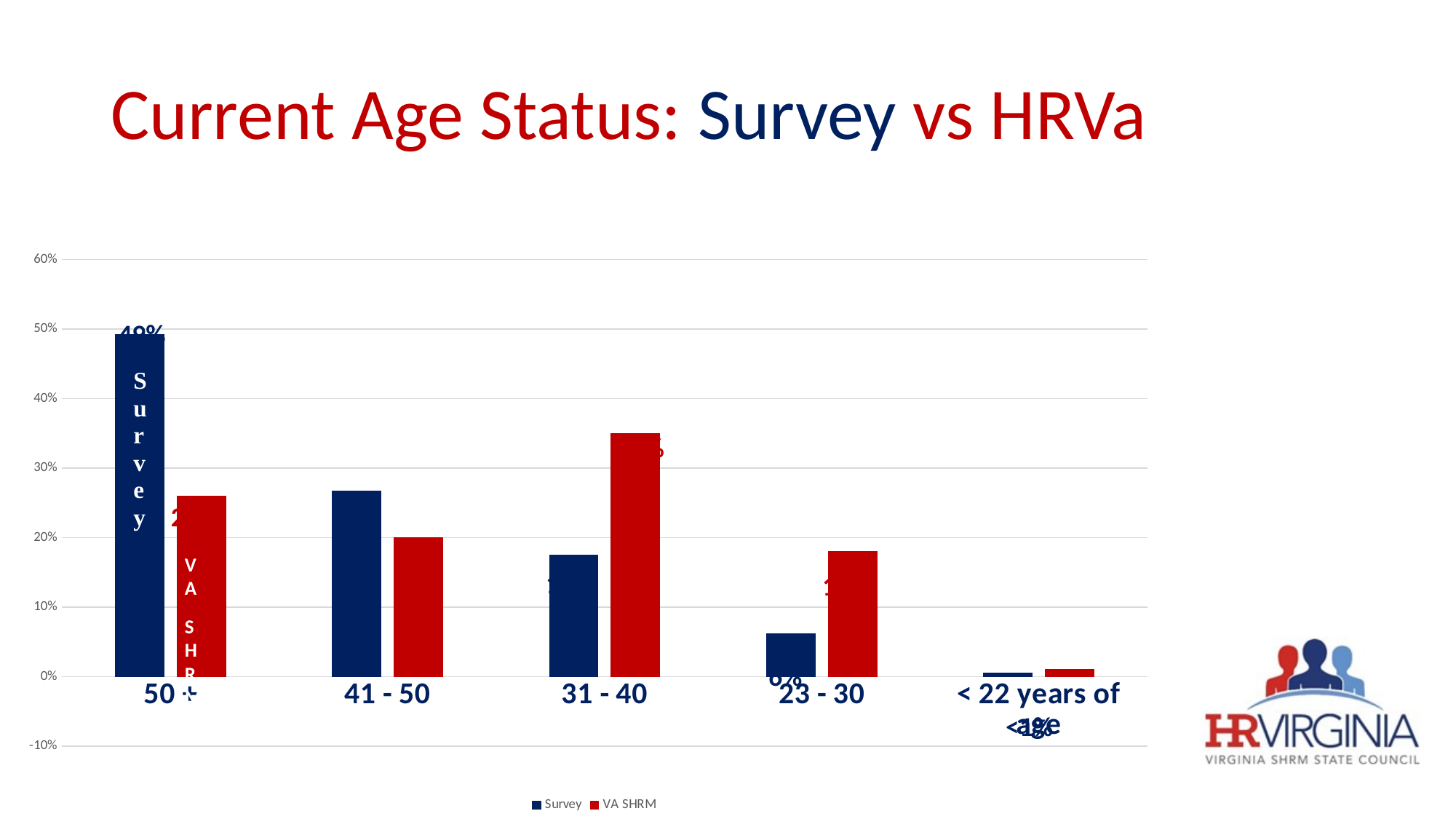
For the 31 - 40 category, which series has the larger value, Survey or VA SHRM? VA SHRM Which age category has the highest VA SHRM value? 31 - 40 Do the Survey values rise or fall moving from 50 + to < 22 years of age along the x axis? fall How many series does the legend list? 2 Is the VA SHRM value for 23 - 30 greater or less than 10%? greater How many age categories are shown on the x axis? 5 Is the Survey value for 50 + greater or less than 40%? greater For the 41 - 50 category, which series has the larger value, Survey or VA SHRM? Survey Which age category has the highest Survey value? 50 + Which age category has the lowest VA SHRM value? < 22 years of age What kind of chart is shown on the slide? bar chart Which colour represents the VA SHRM series? red